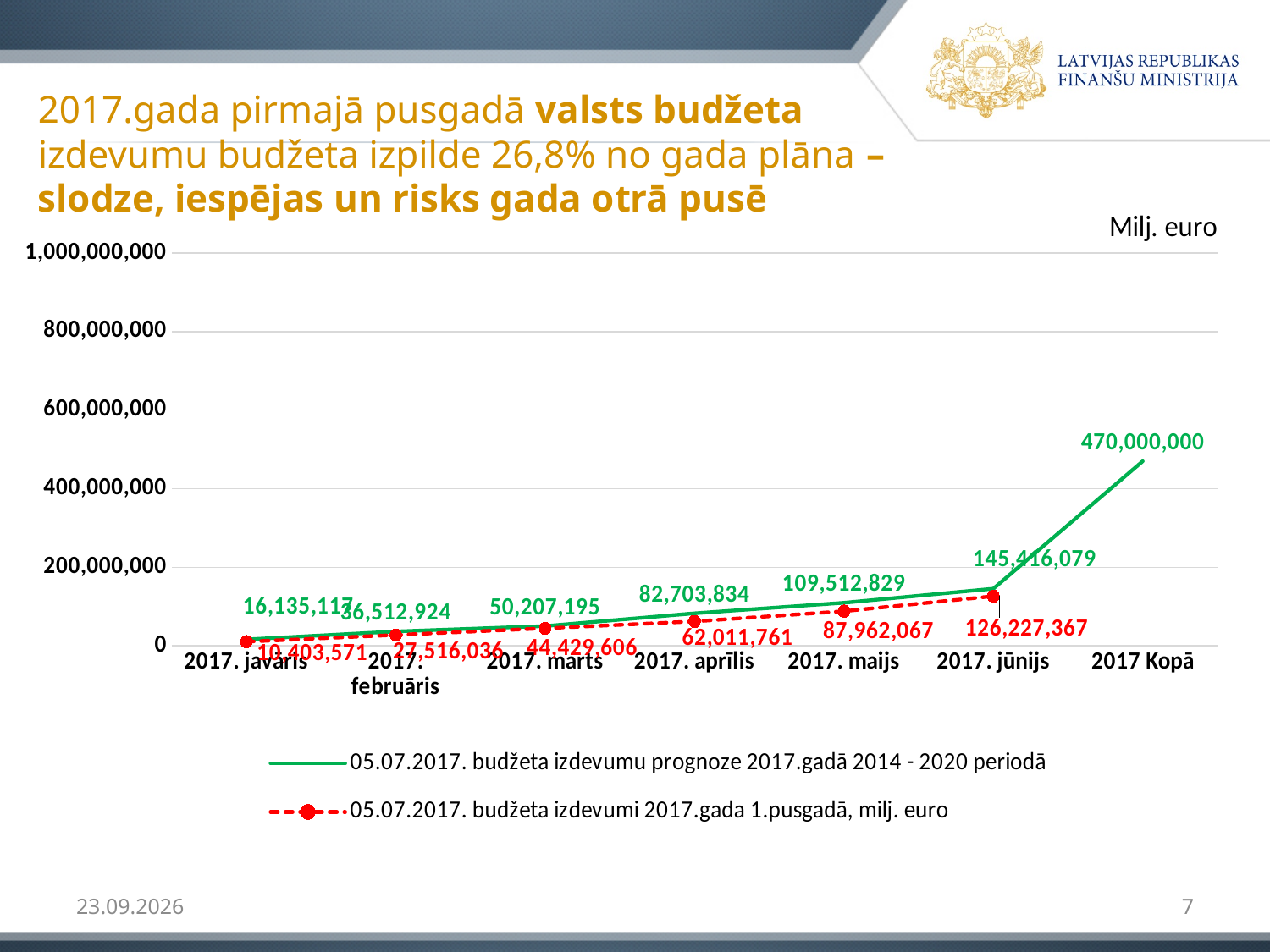
Which category has the lowest value on the red dashed line (budžeta izdevumi 2017.gada 1.pusgadā)? 2017. janvāris How many categories are shown on the x axis? 7 What type of chart is shown on the slide? line chart For 2017. aprīlis, which is larger: the green line value or the red dashed line value? the green line value (82,703,834) How many series does the legend list? 2 What is the value of the green line (budžeta izdevumu prognoze) for 2017 Kopā? 470,000,000 Do the values of the red dashed line rise or fall from 2017. janvāris to 2017. jūnijs? rise What is the value of the red dashed line (budžeta izdevumi 2017.gada 1.pusgadā) for 2017. janvāris? 10,403,571 What is the value of the red dashed line (budžeta izdevumi 2017.gada 1.pusgadā) for 2017. jūnijs? 126,227,367 Which category has the highest value on the green line (budžeta izdevumu prognoze)? 2017 Kopā What is the difference between the green line and the red dashed line values for 2017. jūnijs? 19,188,712 What is the value of the green line (budžeta izdevumu prognoze) for 2017. maijs? 109,512,829